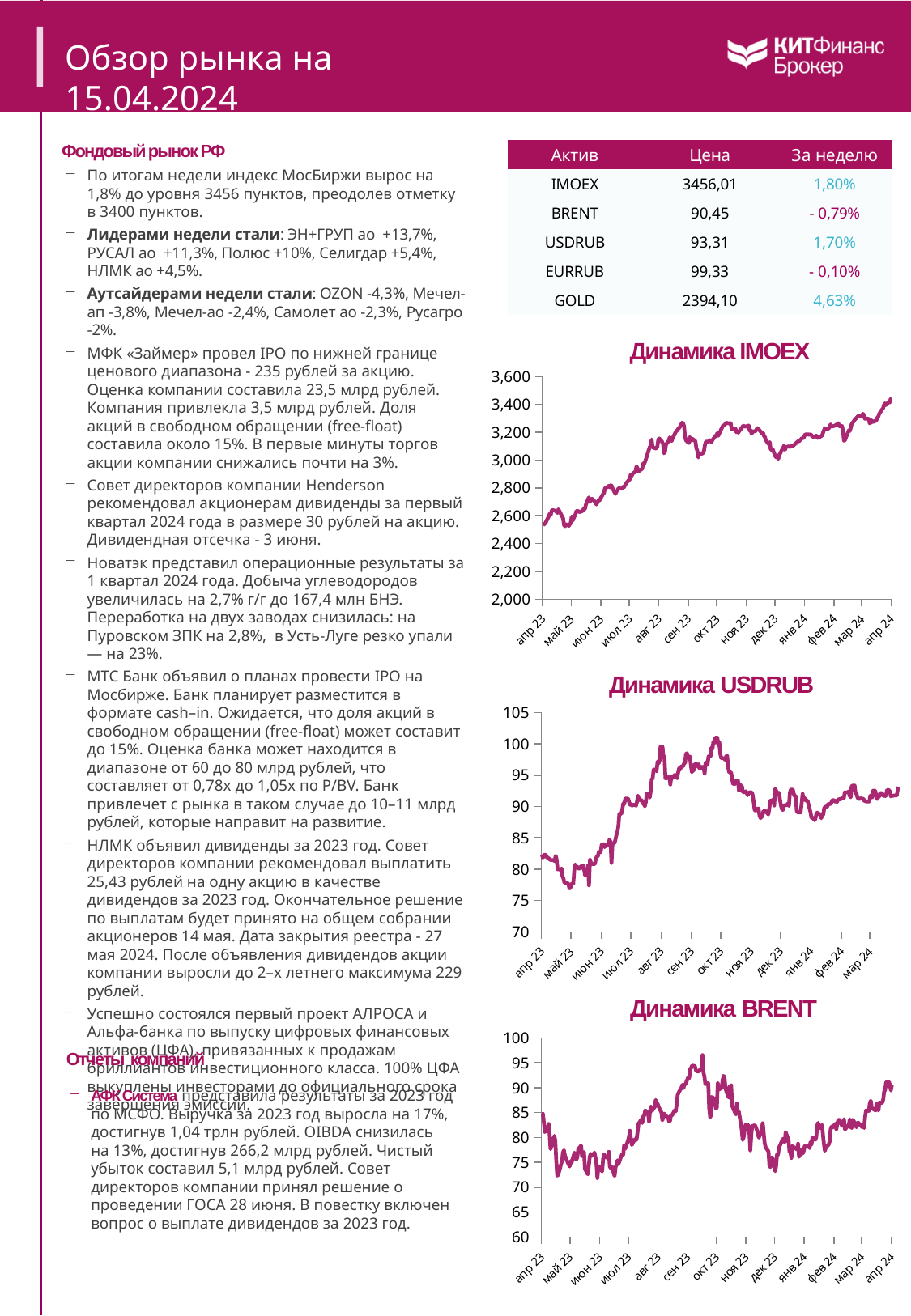
How many month labels are shown on the x axis of the 'Динамика IMOEX' chart? 13 How many month labels are shown on the x axis of the 'Динамика USDRUB' chart? 12 In the 'Динамика IMOEX' chart, do values overall rise or fall from апр 23 to апр 24? rise In the 'Динамика USDRUB' chart, around which month does the line reach its highest point? окт 23 In the 'Динамика IMOEX' chart, is the value at апр 23 greater or less than 2,800? less In the 'Динамика USDRUB' chart, around which month does the line reach its lowest point? май 23 In the 'Динамика BRENT' chart, is the value at дек 23 greater or less than 80? less In the 'Динамика IMOEX' chart, is the value at апр 24 greater or less than 3,200? greater What is the highest value shown on the y axis of the 'Динамика USDRUB' chart? 105 What kind of chart is the 'Динамика IMOEX' chart? line chart